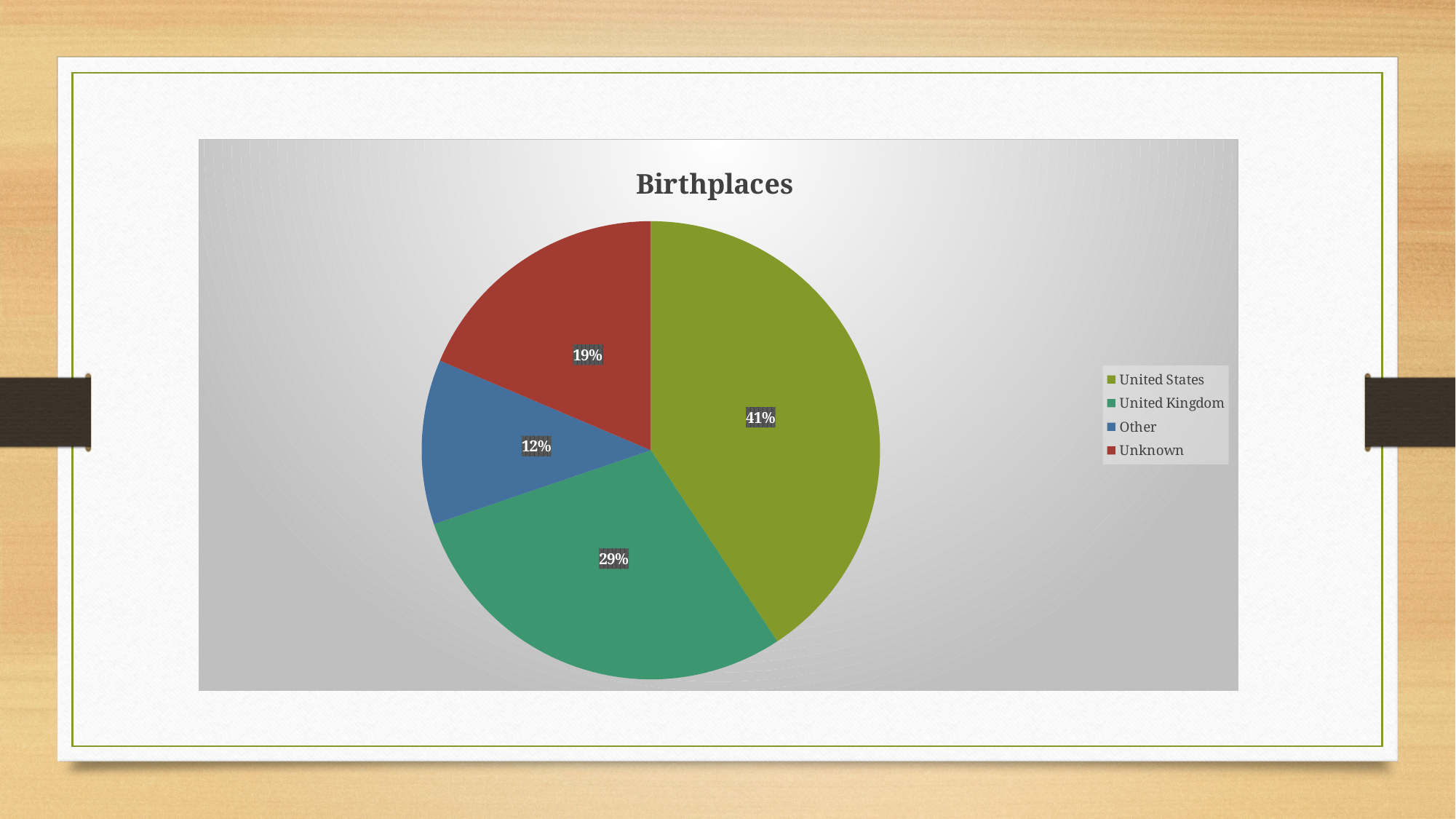
What percentage of the pie is United Kingdom? 29% How many categories does the pie chart have? 4 What is the title of the chart? Birthplaces Which colour represents Unknown in the legend? red What percentage of the pie is United States? 41% What is the difference between the United States share and the United Kingdom share? 12% Which category has the largest share of the pie? United States Which is larger, the Unknown share or the Other share? Unknown What percentage of the pie is Other? 12% What type of chart is shown on the slide? pie chart Which category has the smallest share of the pie? Other What percentage of the pie is Unknown? 19%